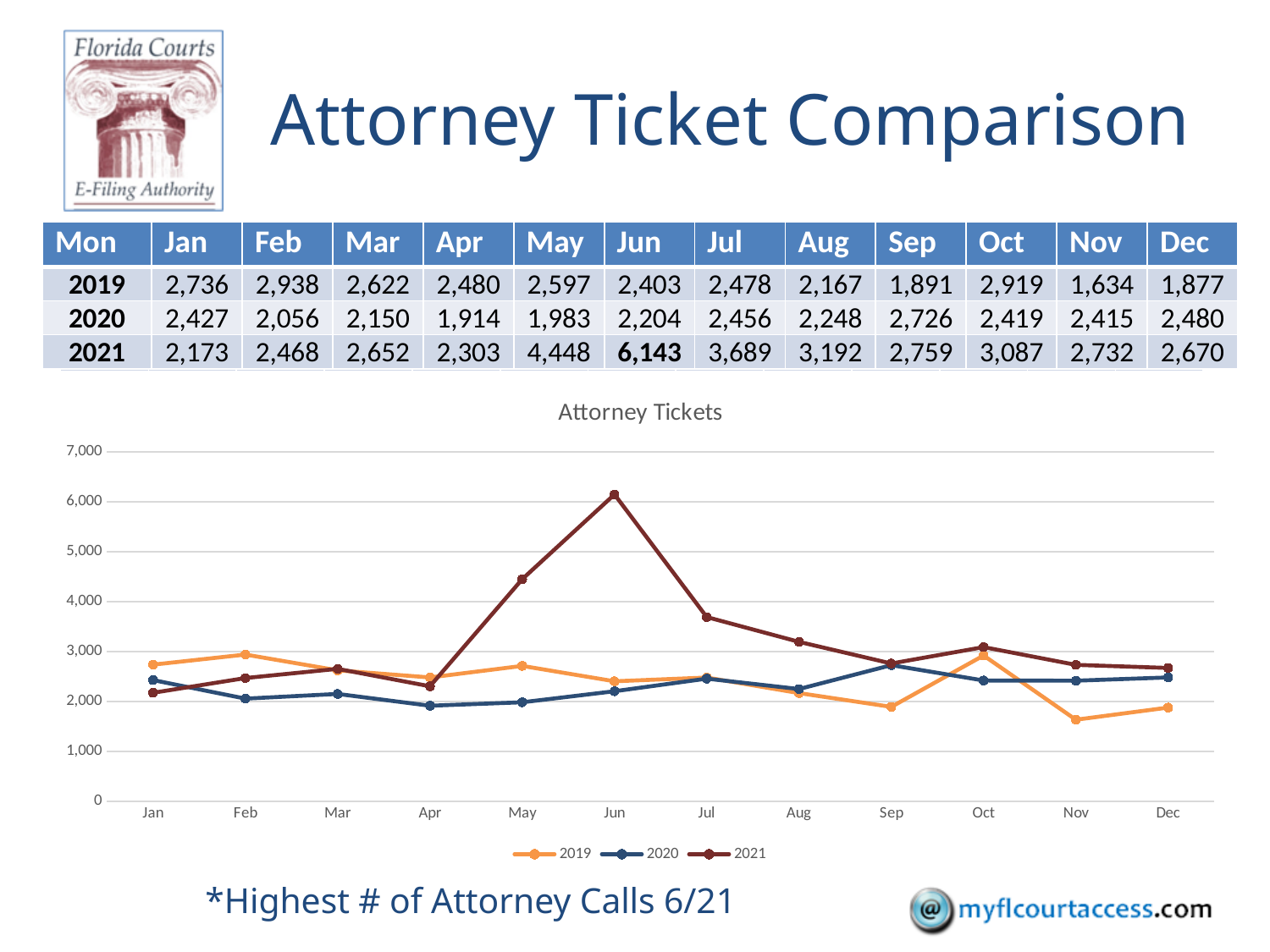
What is the difference between the 2021 and 2020 values in Jun? 3,939 What is the value for 2020 in Sep? 2,726 What kind of chart is shown on the slide? line chart Does the 2021 series rise or fall from Jun to Sep? fall What is the value for 2021 in Jun on the Attorney Tickets chart? 6,143 In which month does the 2021 series reach its highest value? Jun Is the value for 2021 in May greater or less than 4,000? greater How many series does the legend list? 3 Which is larger in Oct: the 2019 value or the 2021 value? 2021 How many months are plotted along the x axis? 12 In which month is the 2019 series at its lowest? Nov What is the value for 2019 in Nov? 1,634